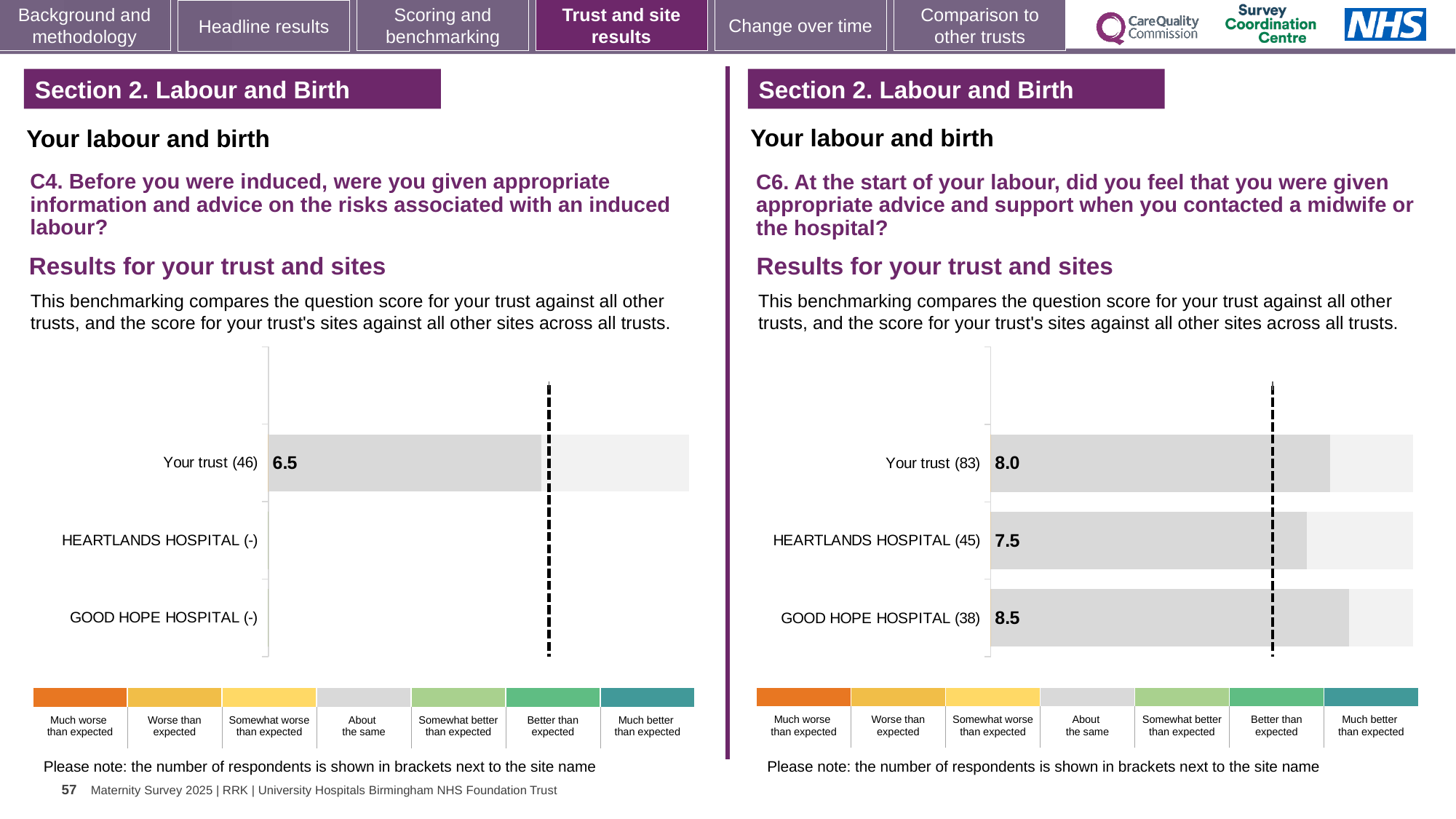
How many categories are listed on the y axis of the C4 chart on the left? 3 In the C6 chart on the right, which has the larger score, Your trust or HEARTLANDS HOSPITAL? Your trust In the C6 chart on the right, which site or trust has the highest score? GOOD HOPE HOSPITAL In the C6 chart on the right, what is the difference between the scores for GOOD HOPE HOSPITAL and HEARTLANDS HOSPITAL? 1.0 In the C6 chart on the right, what is the score for Your trust? 8.0 In the C4 chart on the left, how many respondents are shown in brackets for Your trust? 46 In the C4 chart on the left, what is the score for Your trust? 6.5 In the C6 chart on the right, how many respondents are shown in brackets for Your trust? 83 In the C6 chart on the right, what is the score for GOOD HOPE HOSPITAL? 8.5 In the C6 chart on the right, what is the score for HEARTLANDS HOSPITAL? 7.5 In the C6 chart on the right, which site or trust has the lowest score? HEARTLANDS HOSPITAL What kind of chart is the C6 chart on the right? Bar chart